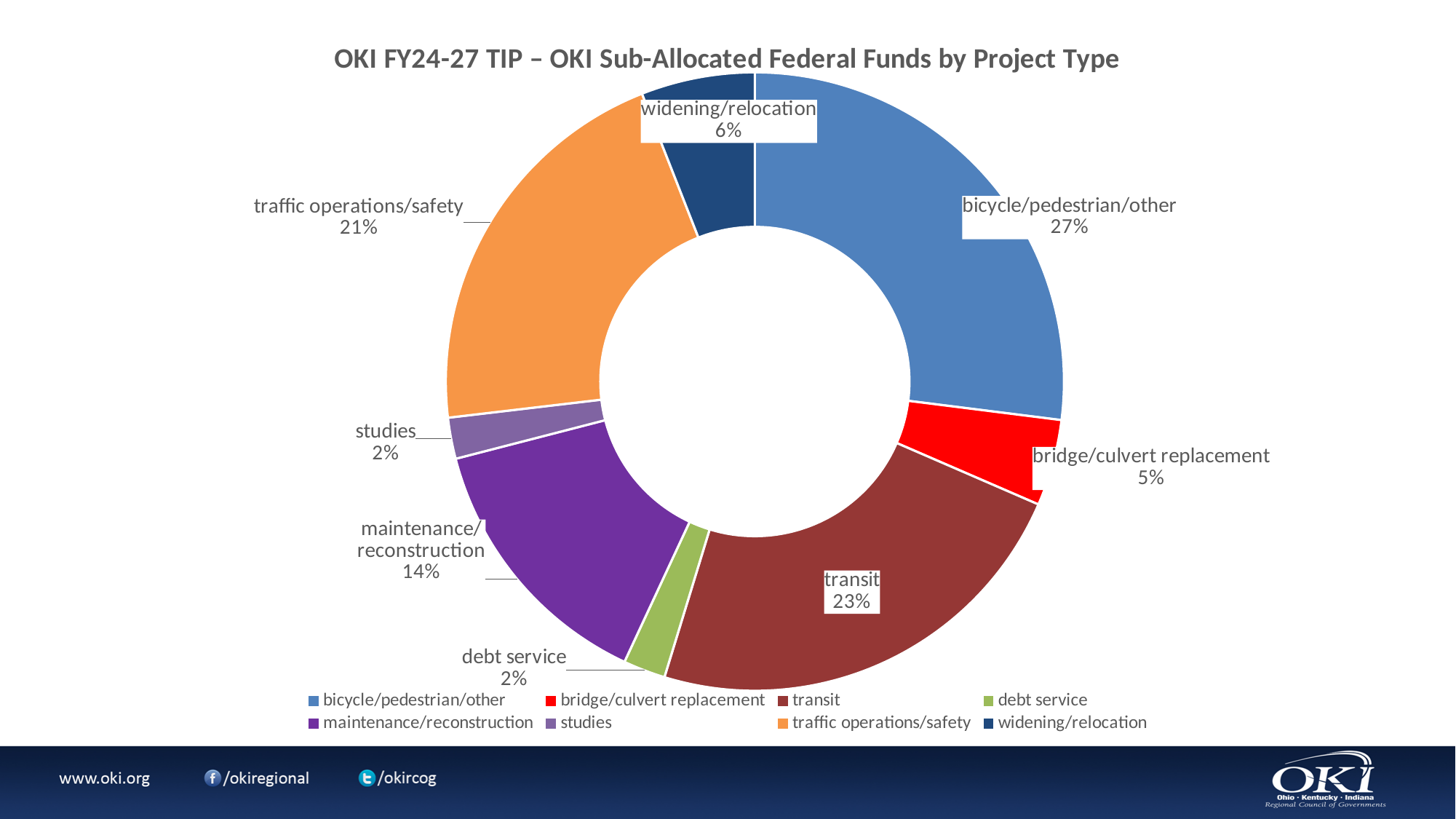
How many project types are shown in the chart? 8 What share does traffic operations/safety receive? 21% What percentage is shown for maintenance/reconstruction? 14% What kind of chart is shown on the slide? pie chart (doughnut) What share of OKI sub-allocated federal funds goes to bicycle/pedestrian/other? 27% Which receives a larger share: widening/relocation or bridge/culvert replacement? widening/relocation Which project types are tied for the smallest share of funds? studies and debt service What percentage of funds is allocated to transit? 23% What colour is the transit slice? dark red How many percentage points larger is the transit share than the maintenance/reconstruction share? 9 Which project type receives the largest share of funds? bicycle/pedestrian/other What is the title of the chart? OKI FY24-27 TIP – OKI Sub-Allocated Federal Funds by Project Type